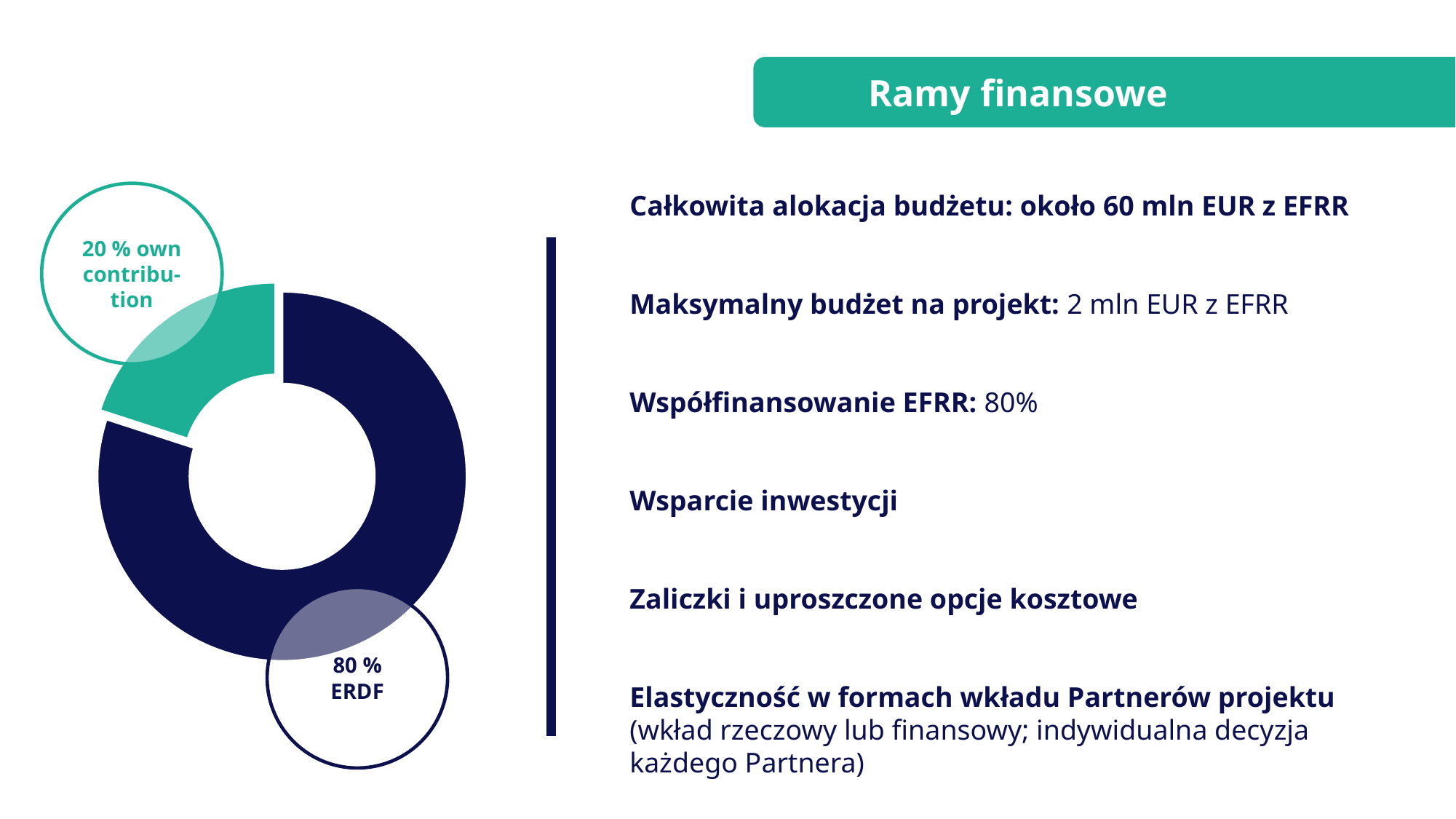
What share of the donut chart is labelled own contribution? 20 % What colour is the ERDF slice in the donut chart? dark navy blue What colour is the own contribution slice in the donut chart? teal green What share of the donut chart is labelled ERDF? 80 % By how many percentage points does the ERDF share exceed the own contribution share in the donut chart? 60 percentage points Which slice of the donut chart is the largest? ERDF Which slice of the donut chart is the smallest? own contribution How many slices does the donut chart have? 2 What share of the whole does the ERDF slice represent? 80 % Which is larger in the donut chart, the ERDF slice or the own contribution slice? ERDF What kind of chart is shown on the left of the slide? donut (pie) chart What do the two slices of the donut chart add up to? 100 %